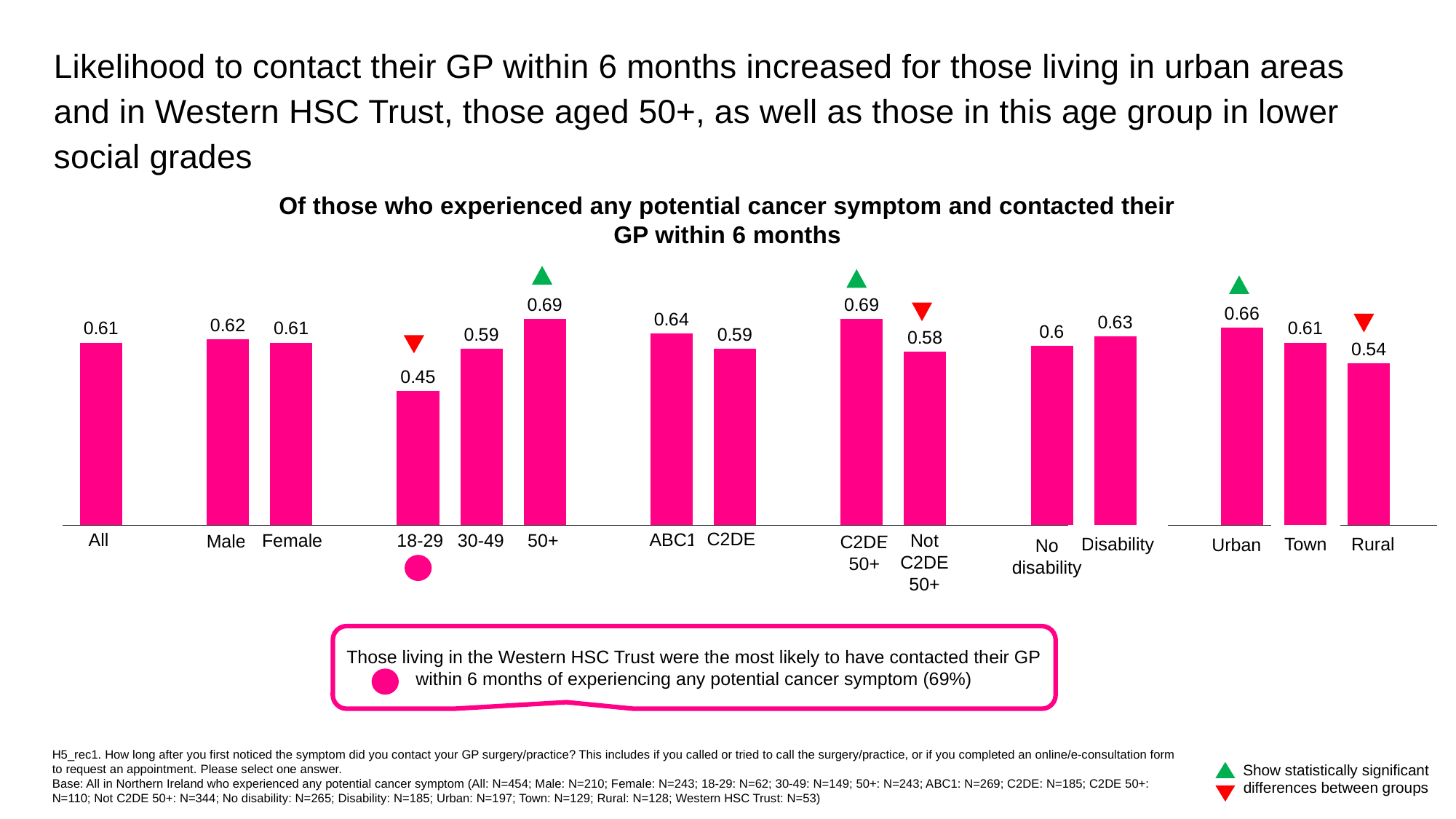
Which has a higher value, Rural or Town? Town Which category has the lowest value? 18-29 How many categories are plotted in the chart? 15 What kind of chart is shown on the slide? Bar chart What is the value for Disability? 0.63 What is the value for Not C2DE 50+? 0.58 What is the difference between the values for 50+ and 18-29? 0.24 Which has a higher value, ABC1 or C2DE? ABC1 What is the value for Urban? 0.66 What is the value for the 18-29 age group? 0.45 What is the value for All? 0.61 What is the difference between the values for Urban and Rural? 0.12